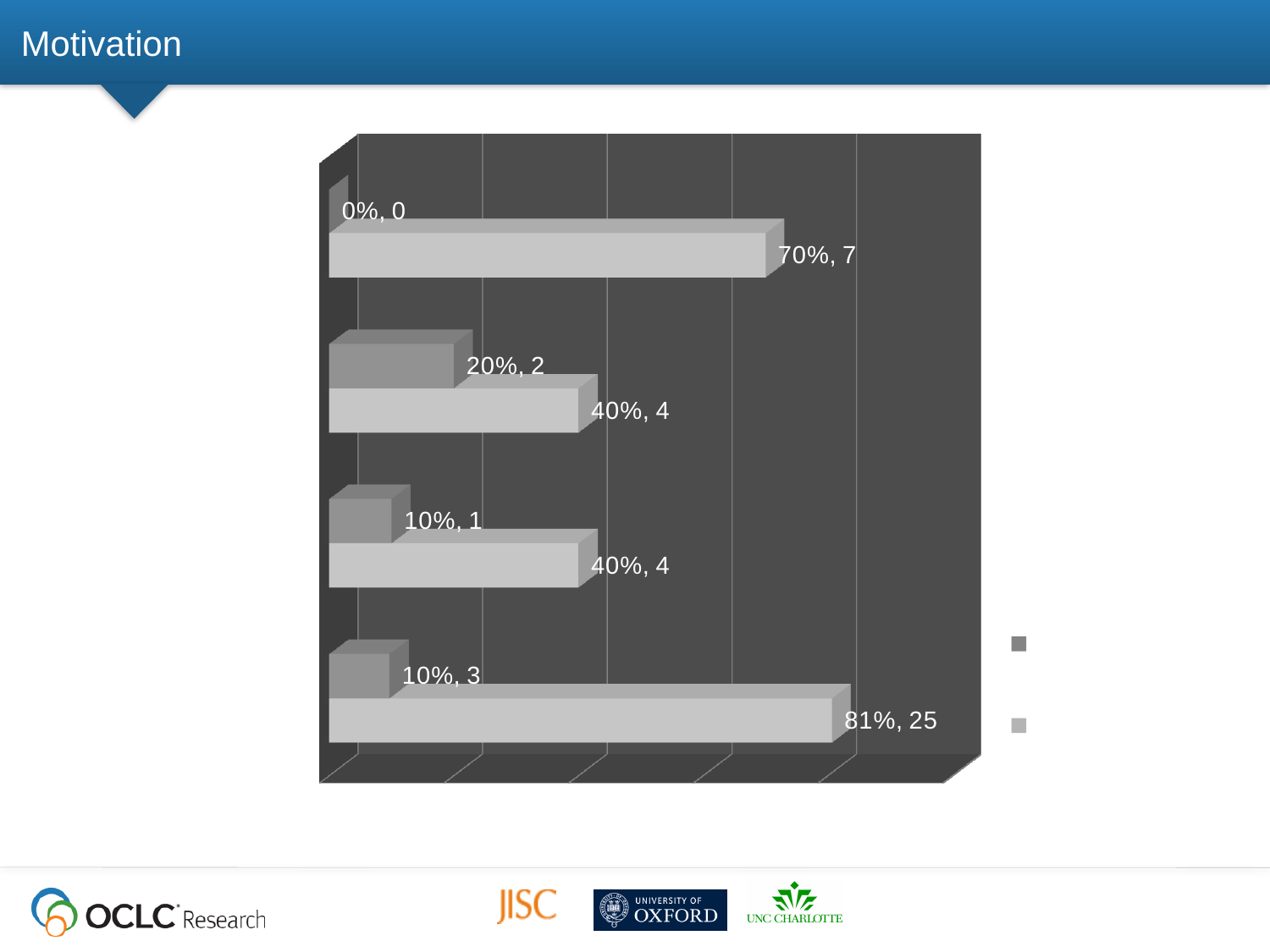
What is the title shown at the top of the slide? Motivation What is the difference in count between the light grey bar in the bottom group (25) and the light grey bar in the top group (7)? 18 How many series does the legend list? 2 What is the data label on the dark grey bar in the top group? 0%, 0 How many groups of bars (categories) does the chart show? 4 What is the data label on the light grey bar in the bottom group? 81%, 25 Which is larger: the light grey bar in the top group or the light grey bar in the second group from the top? the top group What kind of chart is shown on the slide? bar chart What is the data label on the light grey bar in the top group? 70%, 7 What is the data label on the dark grey bar in the second group from the top? 20%, 2 Which group has the shortest dark grey bar? the top group Which group has the longest light grey bar? the bottom group